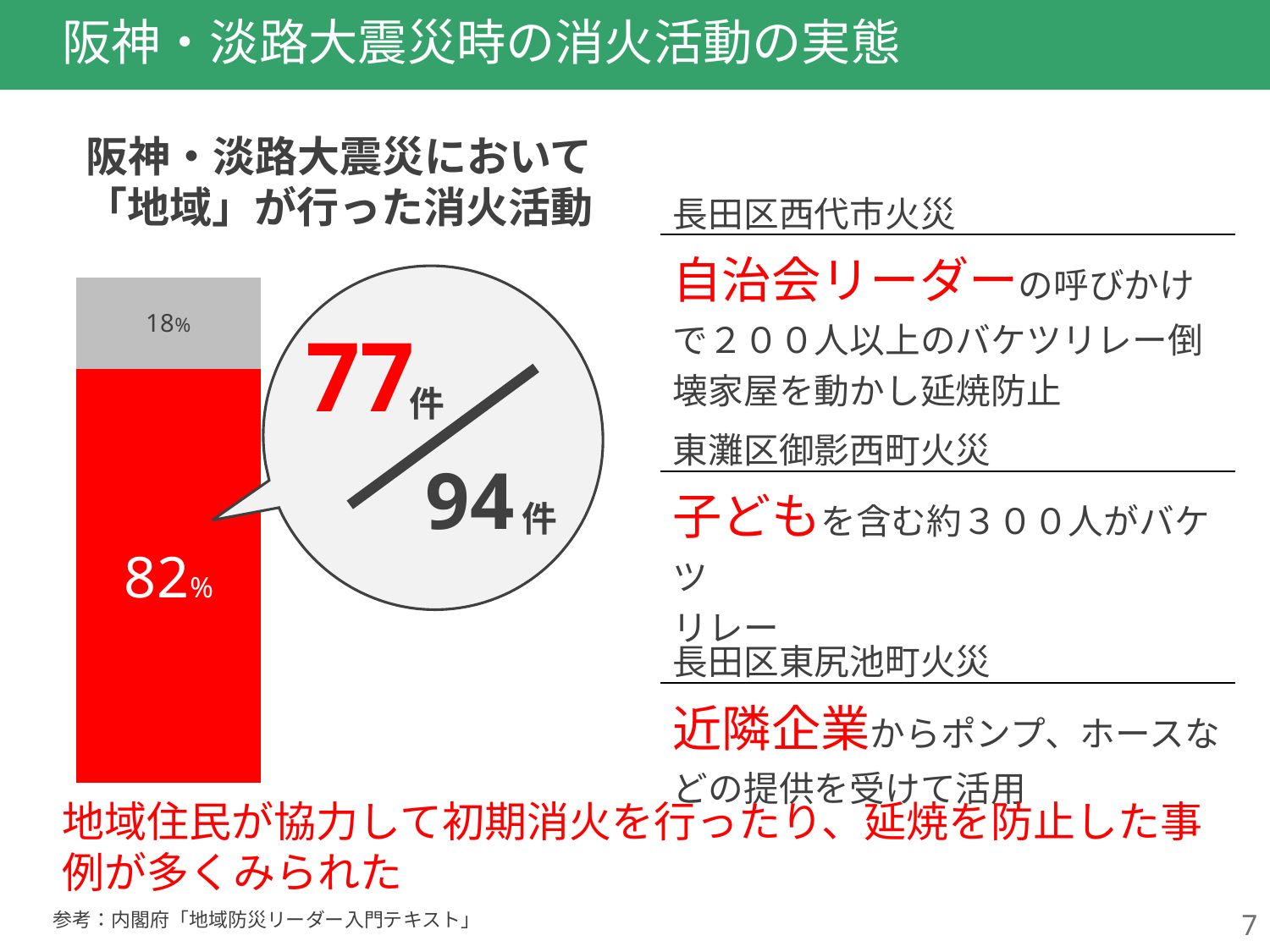
What is the difference in percentage points between the red segment (82%) and the gray segment (18%)? 64 What colour is the segment labelled 18%? gray What is the total of the two segments of the stacked bar? 100% What percentage is shown on the gray segment of the bar chart? 18% What kind of chart is shown on the slide? bar chart How many segments does the stacked bar have? 2 What number of cases (件) is shown in red in the callout bubble next to the bar? 77件 What percentage is shown on the red segment of the bar chart? 82% What is the title of the chart? 阪神・淡路大震災において「地域」が行った消火活動 Is the value of the red segment greater or less than 50%? greater Which segment of the bar is larger, the red one or the gray one? the red one What number of cases (件) is shown in black in the callout bubble next to the bar? 94件